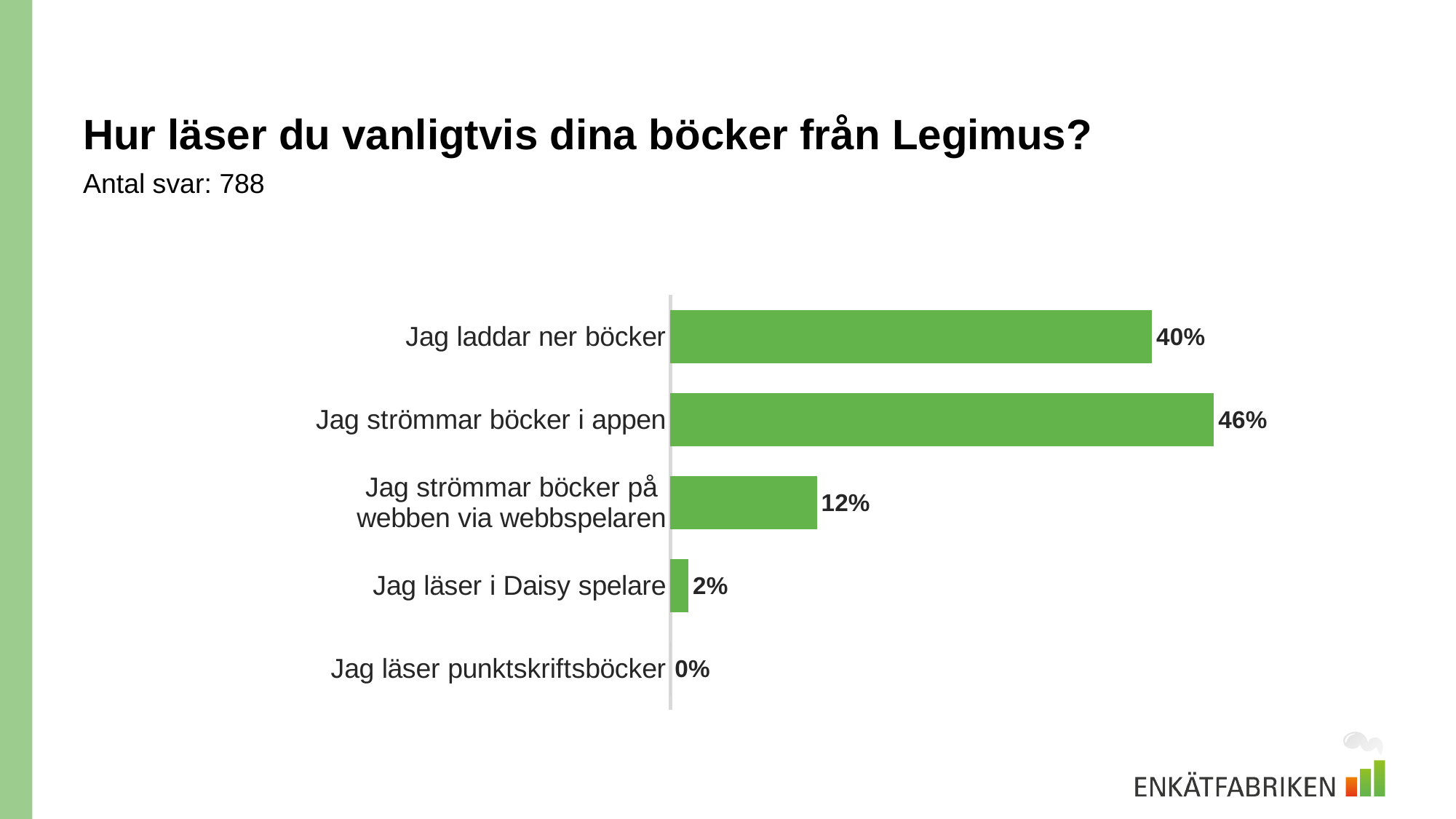
What is the value for "Jag läser i Daisy spelare"? 2% What is the value for "Jag laddar ner böcker"? 40% What is the number of responses (Antal svar) stated on the slide? 788 What is the value for "Jag strömmar böcker i appen"? 46% Which category has the lowest value? Jag läser punktskriftsböcker Which category has the highest value? Jag strömmar böcker i appen Which is larger, the value for "Jag strömmar böcker på webben via webbspelaren" or the value for "Jag läser i Daisy spelare"? Jag strömmar böcker på webben via webbspelaren What is the value for "Jag strömmar böcker på webben via webbspelaren"? 12% What is the value for "Jag läser punktskriftsböcker"? 0% How many categories are shown in the chart? 5 What kind of chart is shown on the slide? Bar chart What is the difference between the values for "Jag strömmar böcker i appen" and "Jag laddar ner böcker"? 6%